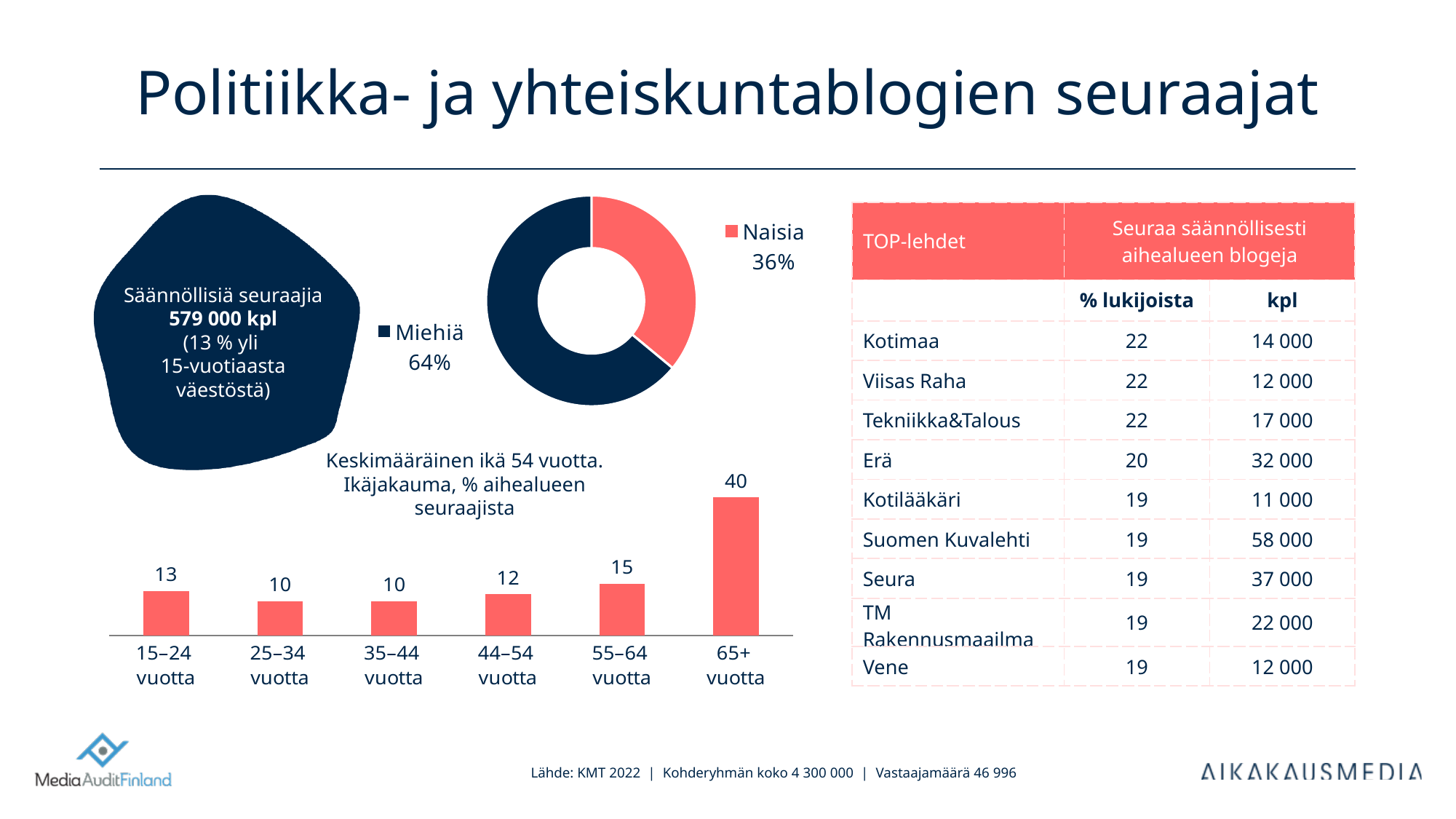
In the age distribution bar chart, which age group has the highest value? 65+ vuotta What type of chart is used to show the age distribution (Ikäjakauma)? Bar chart In the age distribution bar chart, which is larger, the value for 44–54 vuotta or 55–64 vuotta? 55–64 vuotta In the donut chart, what is the difference in percentage points between Miehiä and Naisia? 28 In the age distribution bar chart, what is the value for 15–24 vuotta? 13 In the age distribution bar chart, what is the difference between the values for 65+ vuotta and 55–64 vuotta? 25 In the donut chart, what share is shown for Naisia? 36% How many entries does the legend of the donut chart list? 2 In the donut chart, which group has the larger share, Miehiä or Naisia? Miehiä How many age groups are shown in the age distribution bar chart? 6 In the age distribution bar chart, what is the value for 65+ vuotta? 40 In the donut chart, what share is shown for Miehiä? 64%